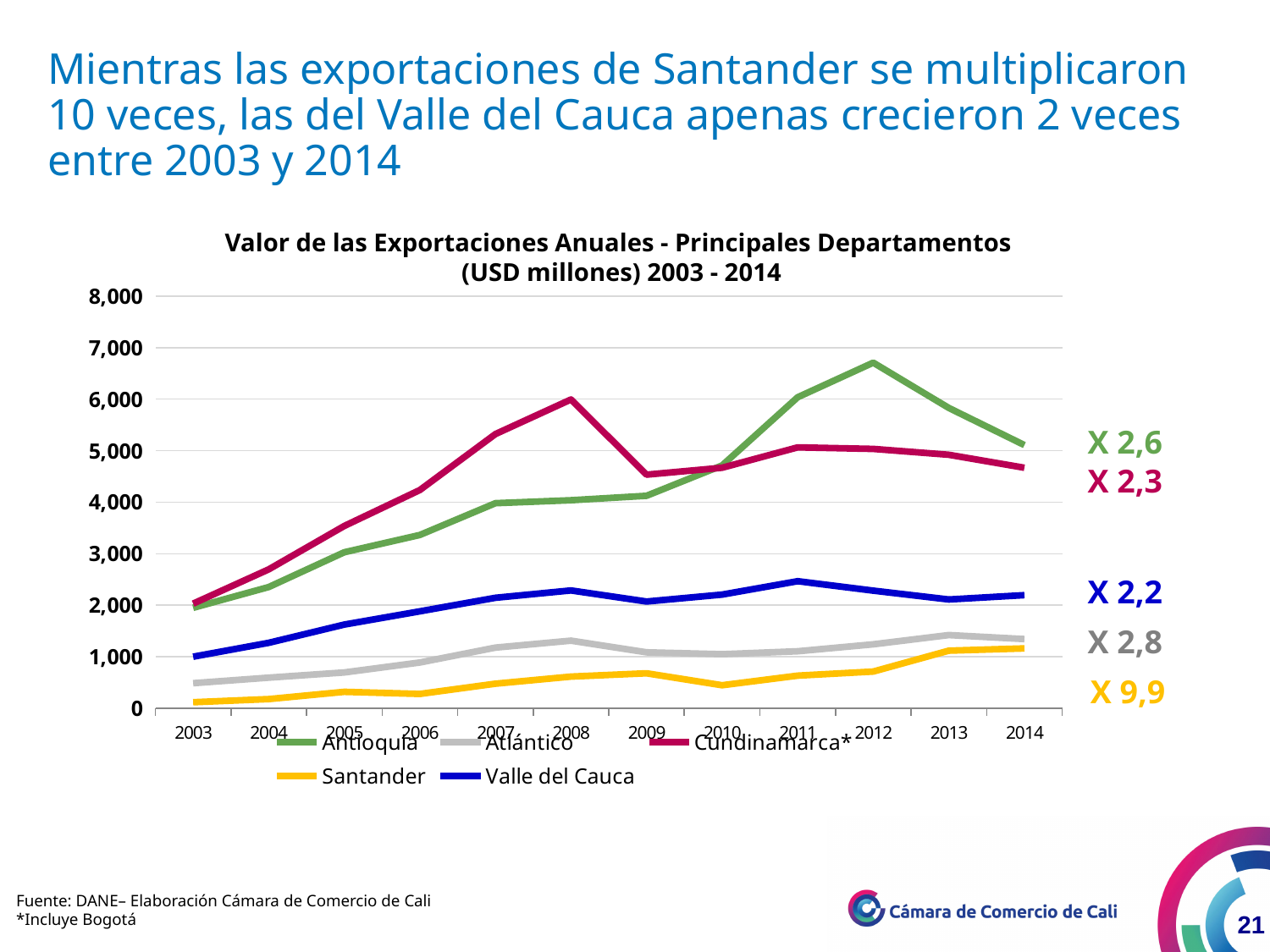
How many years are plotted along the x axis? 12 Is the value for Valle del Cauca in 2011 greater or less than 2,000? greater Which department has the highest export value in 2012? Antioquia How many series does the legend list? 5 What kind of chart is shown on the slide? line chart Which department has the lowest export value in 2003? Santander Is the value for Cundinamarca* in 2007 greater or less than 5,000? greater In 2008, which is larger: the value for Cundinamarca* or the value for Antioquia? Cundinamarca* Is the value for Santander in 2010 greater or less than 1,000? less Do the values for Santander generally rise or fall from 2003 to 2014? rise What multiplier label is shown next to the Santander line at the right of the chart? X 9,9